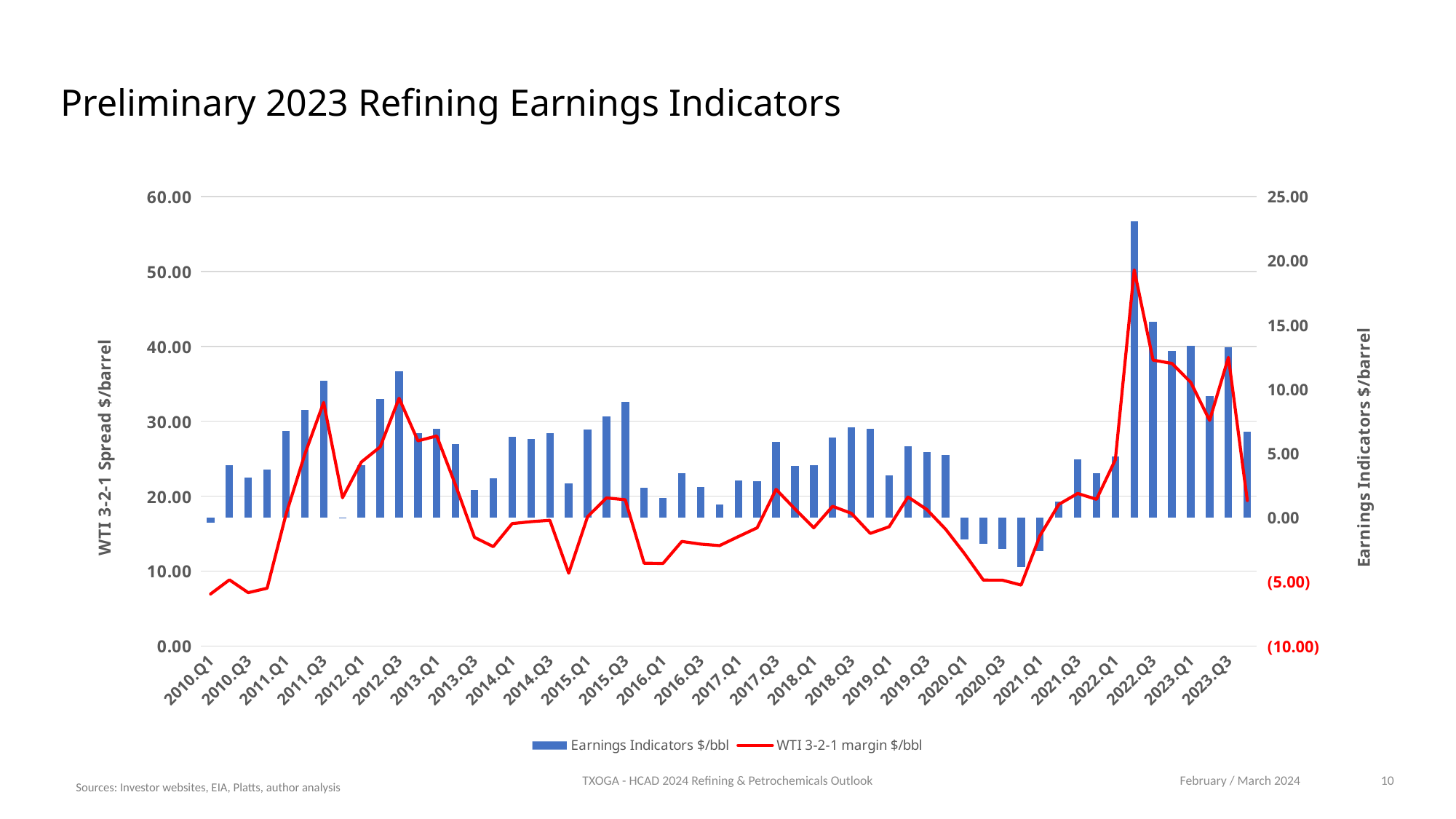
In which quarter is the Earnings Indicators bar the highest? 2022.Q2 Does the WTI 3-2-1 margin line rise or fall from 2022.Q3 to 2023.Q4? fall What kind of chart is shown on the slide? A combination bar and line chart How many series does the legend list? 2 Is the Earnings Indicators value for 2020.Q1 greater or less than 0.00 on the right axis? less Which series is drawn as a red line? WTI 3-2-1 margin $/bbl What is the title of the slide's chart? Preliminary 2023 Refining Earnings Indicators Is the WTI 3-2-1 margin value for 2022.Q3 greater or less than 40.00 on the left axis? less Is the WTI 3-2-1 margin value for 2010.Q1 greater or less than 10.00 on the left axis? less In which quarter is the Earnings Indicators bar the lowest? 2020.Q4 Which is larger, the Earnings Indicators bar for 2022.Q3 or for 2022.Q4? 2022.Q3